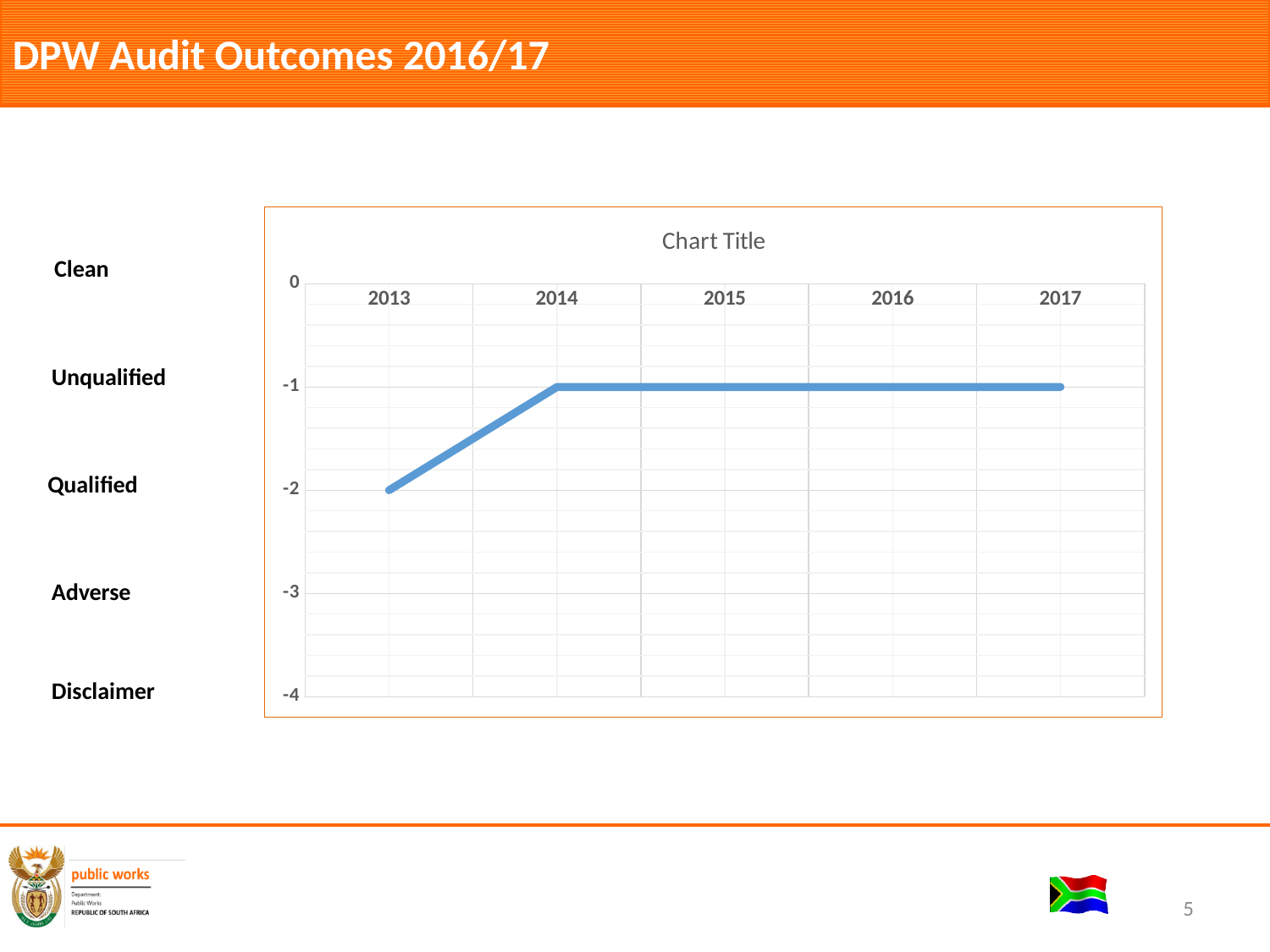
What is the title shown above the chart? Chart Title How many years are plotted along the x axis? 5 Does the line rise, fall or stay flat between 2014 and 2017? stays flat What type of chart is shown on the slide? line chart What is the difference between the values for 2014 and 2013? 1 Does the line rise or fall from 2013 to 2014? rises What is the plotted value for 2014? -1 What is the plotted value for 2017? -1 Which year has the lowest plotted value? 2013 What is the plotted value for 2013? -2 Which is higher on the chart, the value for 2013 or the value for 2015? 2015 Which audit outcome label on the left of the slide aligns with the -1 level of the chart? Unqualified